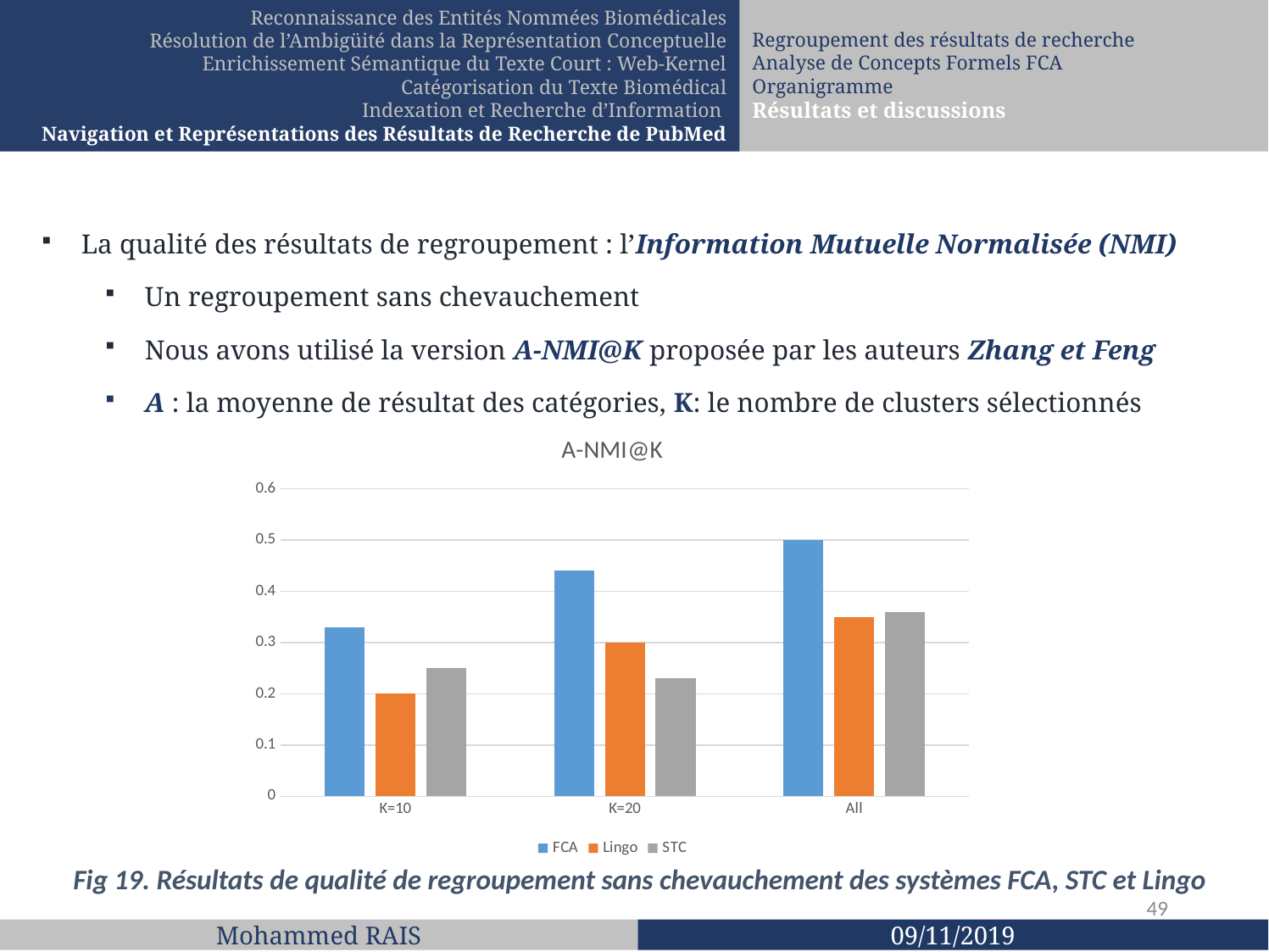
Is the value for STC at K=20 greater or less than 0.3? less In which category is the Lingo value lowest? K=10 In which category does FCA reach its highest value? All At K=20, which is larger, FCA or Lingo? FCA What is the title of the chart? A-NMI@K Is the value for FCA at K=20 greater or less than 0.4? greater What is the value for FCA in the All category? 0.5 How many categories are shown on the x axis of the chart? 3 What type of chart is shown on the slide? bar chart Is the value for STC at K=10 greater or less than 0.2? greater How many series does the chart legend list? 3 What is the value for Lingo at K=20? 0.3